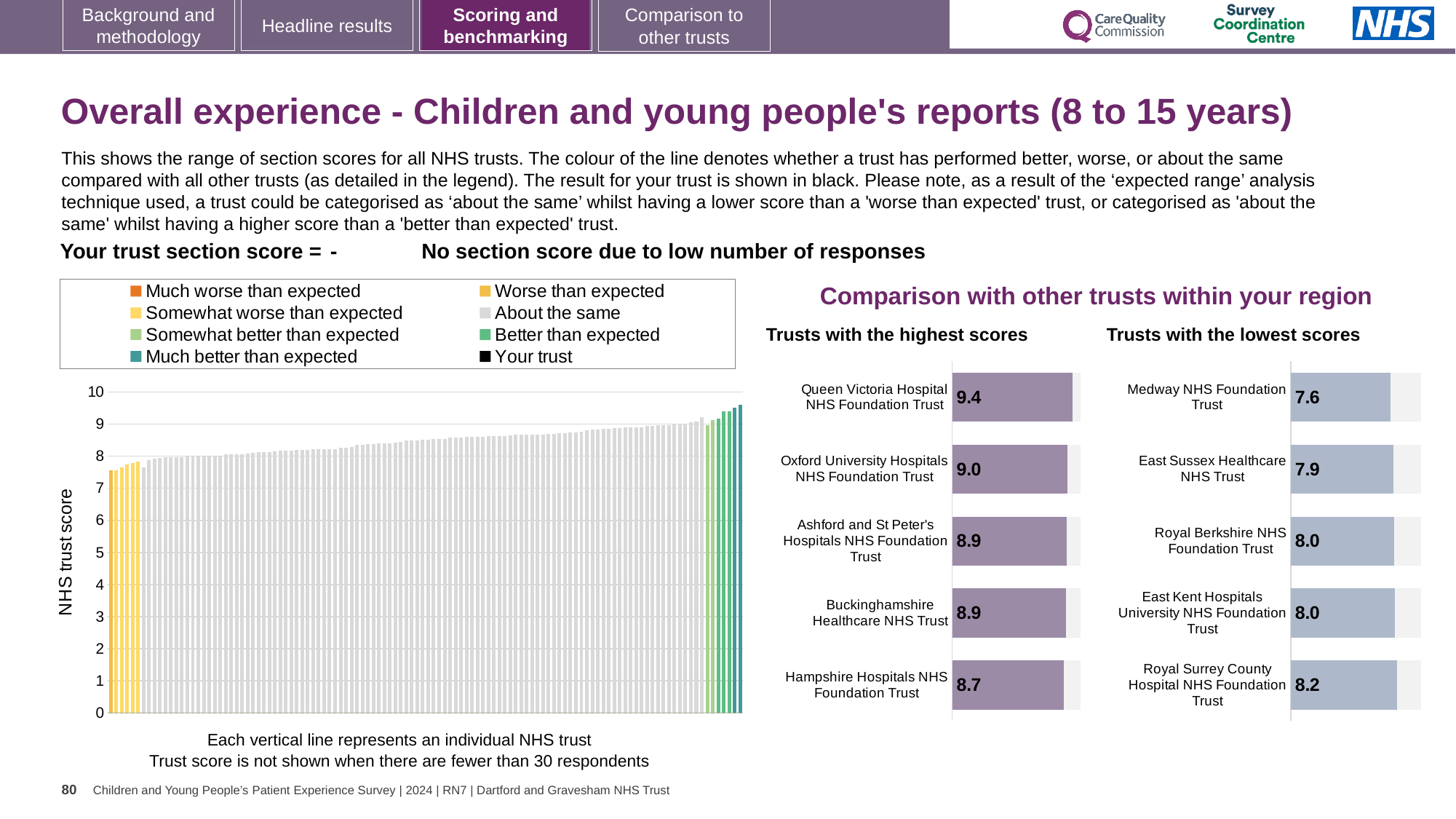
In the 'Trusts with the highest scores' chart, what is the score for Hampshire Hospitals NHS Foundation Trust? 8.7 What type of chart is the large 'NHS trust score' chart on the left of the slide? Bar chart In the 'Trusts with the highest scores' chart, what is the score for Queen Victoria Hospital NHS Foundation Trust? 9.4 In the 'Trusts with the lowest scores' chart, what is the score for Royal Surrey County Hospital NHS Foundation Trust? 8.2 In the 'Trusts with the highest scores' chart, what is the difference between the scores of Queen Victoria Hospital NHS Foundation Trust and Oxford University Hospitals NHS Foundation Trust? 0.4 In the 'NHS trust score' chart, do the bar values rise or fall from left to right along the x axis? Rise How many trusts are shown in the 'Trusts with the highest scores' chart? 5 In the 'Trusts with the highest scores' chart, which trust has the highest score? Queen Victoria Hospital NHS Foundation Trust How many entries does the legend of the 'NHS trust score' chart list? 8 In the 'Trusts with the lowest scores' chart, what is the score for Medway NHS Foundation Trust? 7.6 In the 'Trusts with the lowest scores' chart, which trust has the lowest score? Medway NHS Foundation Trust In the 'Trusts with the lowest scores' chart, which has the higher score: East Sussex Healthcare NHS Trust or Royal Berkshire NHS Foundation Trust? Royal Berkshire NHS Foundation Trust